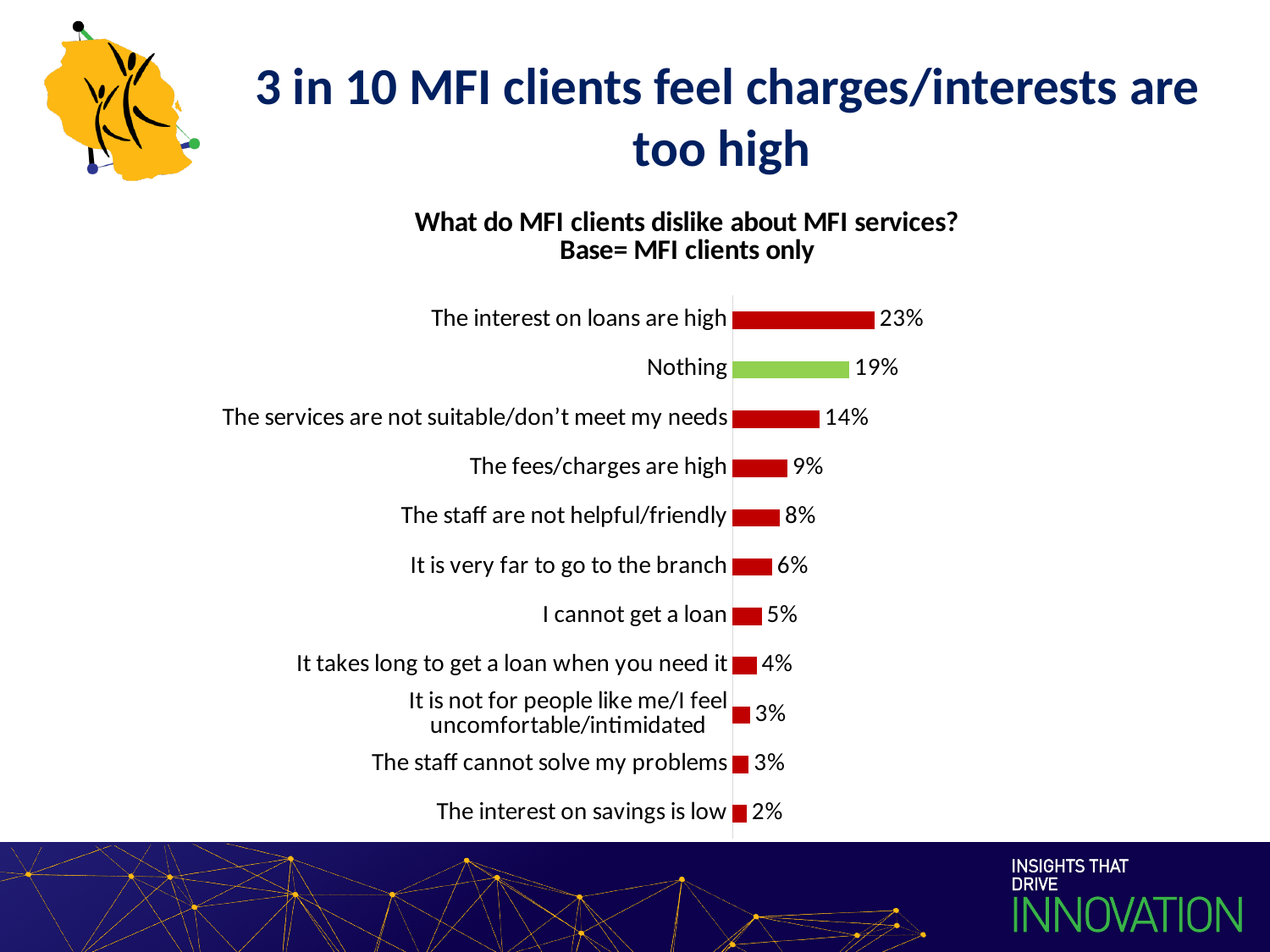
How many categories are shown in the chart? 11 What is the difference between 'Nothing' and 'The services are not suitable/don't meet my needs'? 5% Which is larger: 'The staff are not helpful/friendly' or 'I cannot get a loan'? The staff are not helpful/friendly What is the difference between 'The interest on loans are high' and 'The fees/charges are high'? 14% What percentage of MFI clients said 'Nothing' when asked what they dislike about MFI services? 19% What type of chart is shown on the slide? Bar chart What is the value for 'It is very far to go to the branch'? 6% What is the value for 'The fees/charges are high'? 9% What percentage of MFI clients said the interest on loans are high? 23% Which category has the lowest value in the chart? The interest on savings is low Which bar in the chart is coloured green rather than red? Nothing Which category has the highest value in the chart? The interest on loans are high